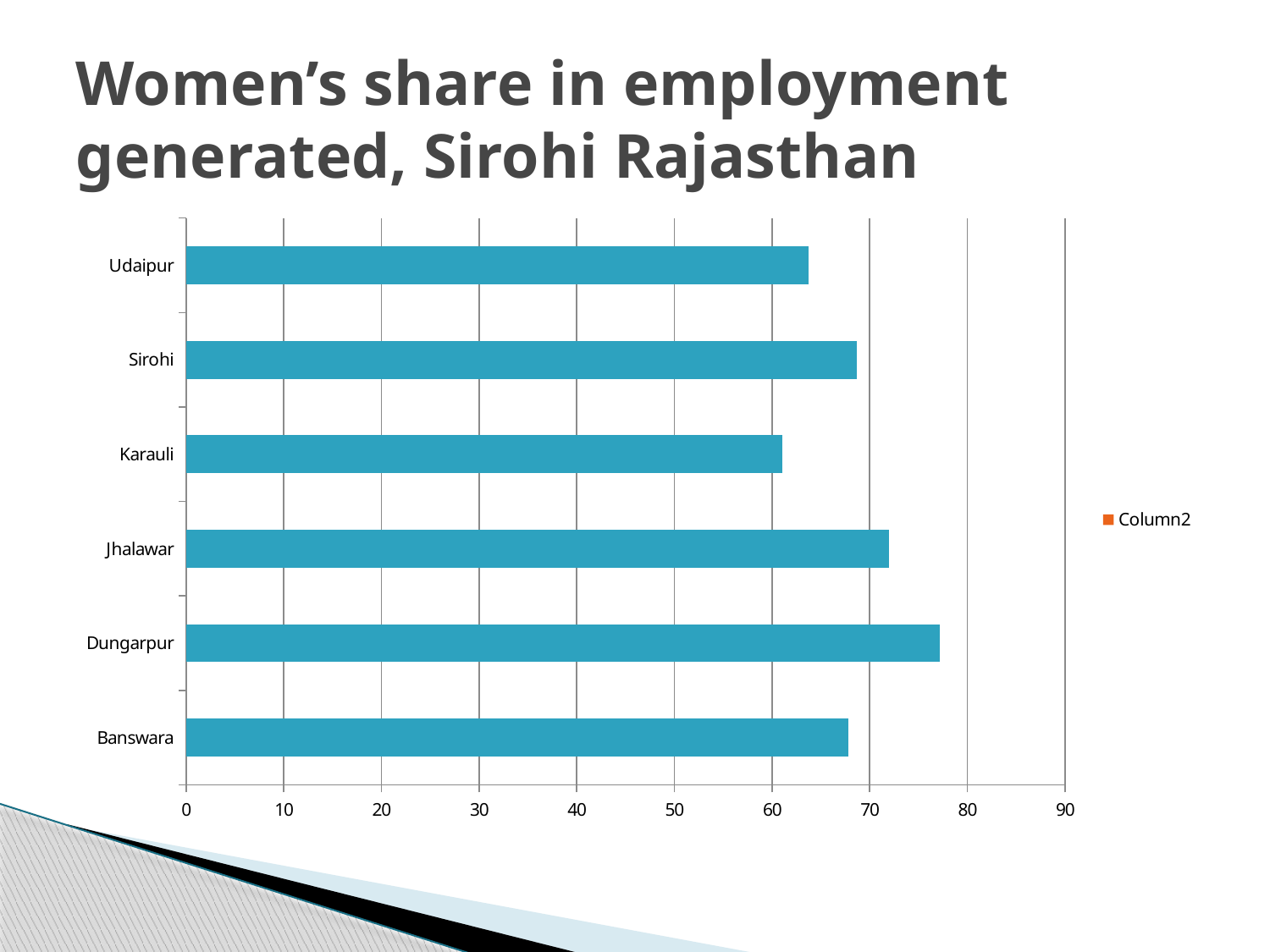
Which is larger, the value for Dungarpur or the value for Udaipur? Dungarpur What is the title of the chart on the slide? Women's share in employment generated, Sirohi Rajasthan What kind of chart is shown on the slide? bar chart Is the value for Udaipur greater or less than 70? less Which district has the highest women's share in employment generated? Dungarpur How many districts are plotted on the chart? 6 Is the value for Karauli greater or less than 70? less Which district has the lowest women's share in employment generated? Karauli Which is larger, the value for Jhalawar or the value for Karauli? Jhalawar Is the value for Dungarpur greater or less than 70? greater How many series does the legend list? 1